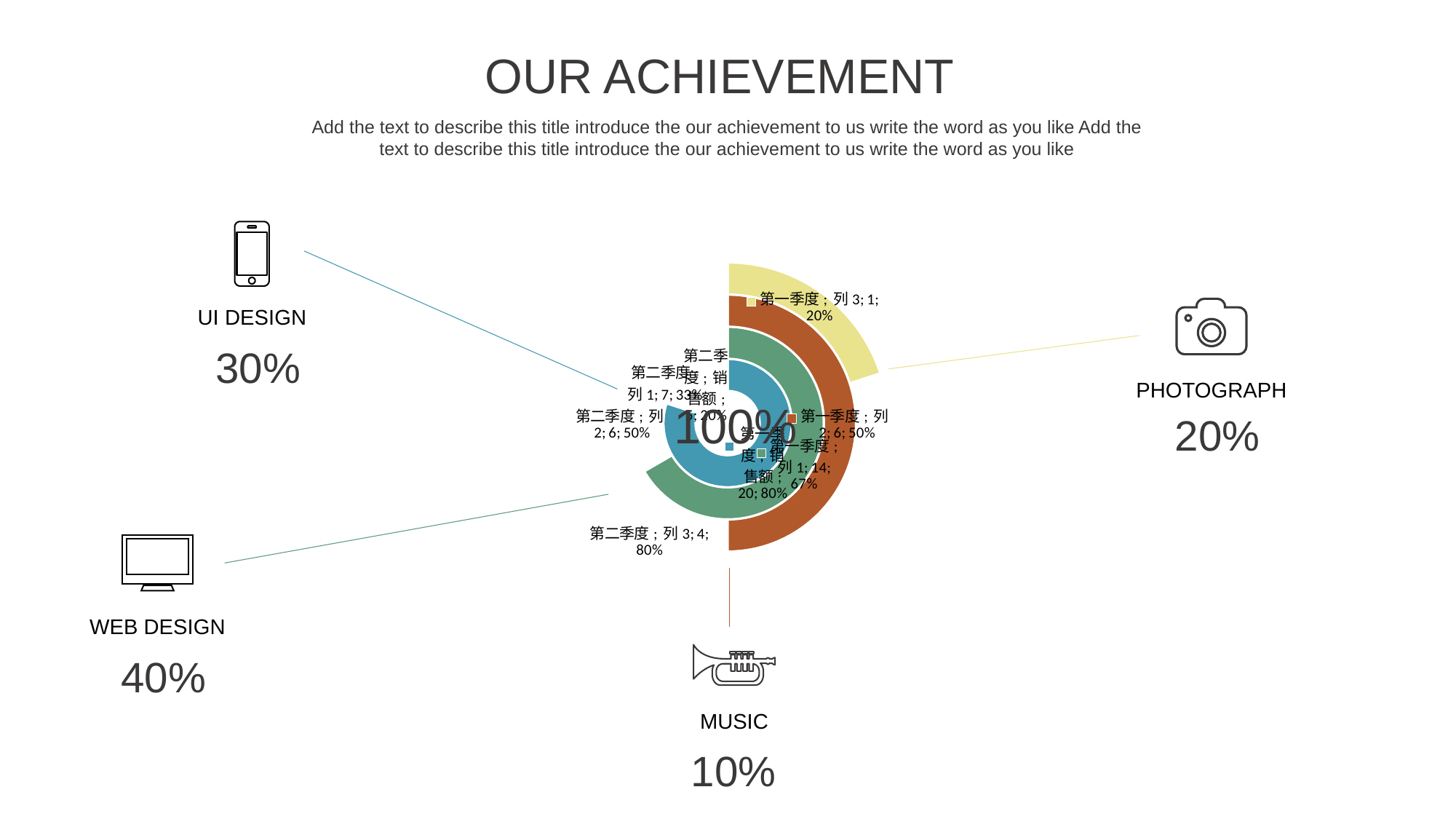
What is the value for 第一季度 in the 列 2 ring? 6 What is the difference between the 第二季度 and 第一季度 values in the 列 3 ring? 3 What is the total of the 列 2 ring (第一季度 plus 第二季度)? 12 What percentage share does 第一季度 have in the 列 3 ring? 20% What percentage share does 第一季度 have in the 列 2 ring? 50% What percentage share does 第二季度 have in the 列 3 ring? 80% What is the value for 第二季度 in the 列 2 ring? 6 What is the value for 第一季度 in the 列 3 ring? 1 How many categories (quarters) does the chart show? 2 What kind of chart is shown on the slide? doughnut chart What is the value for 第二季度 in the 列 3 ring? 4 In the 列 3 ring, which category has the larger value, 第一季度 or 第二季度? 第二季度